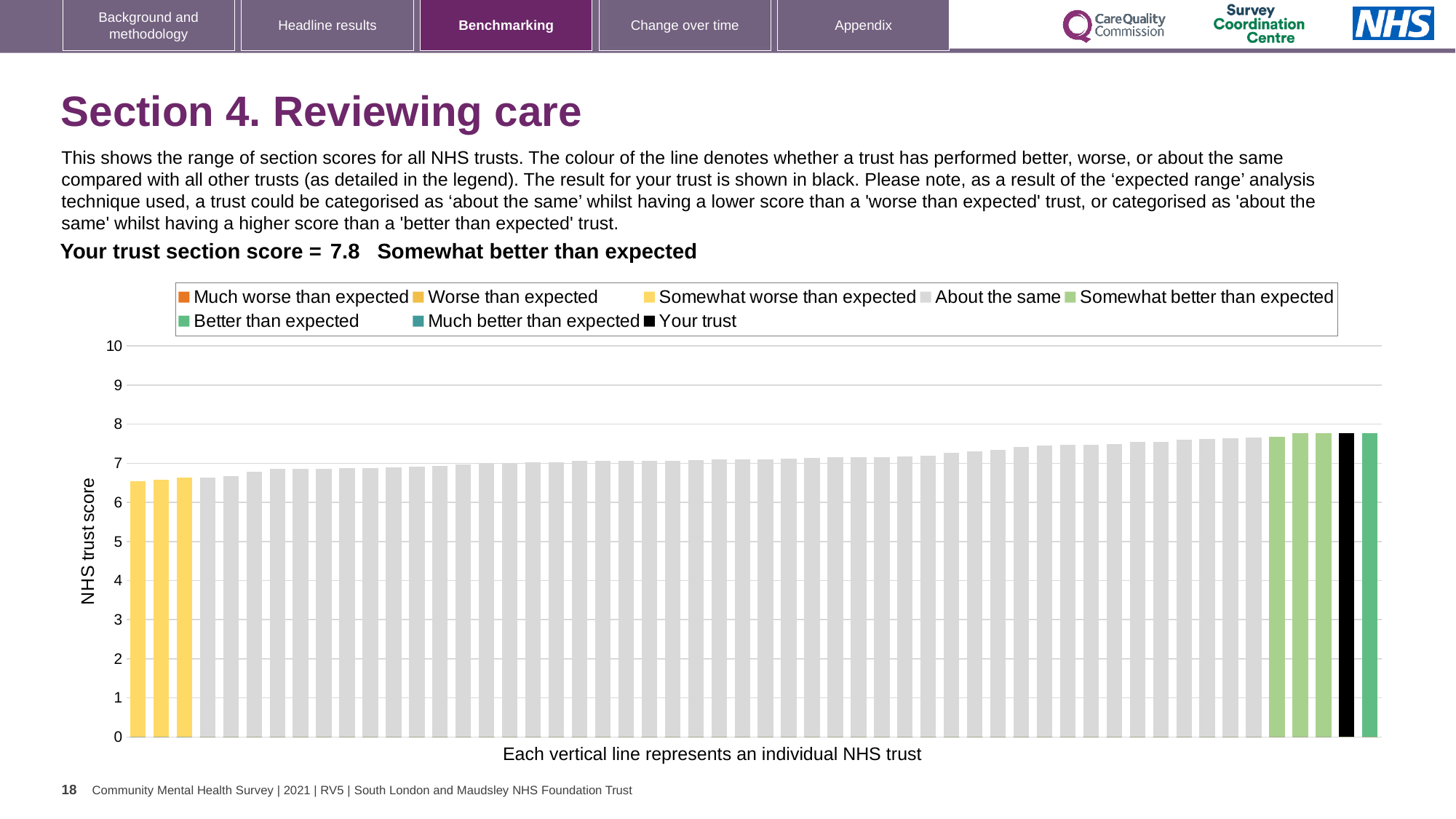
Is the value of the tallest bar in the chart greater or less than 8? less What kind of chart is shown on the slide? bar chart What is the label on the vertical axis of the chart? NHS trust score What is the section score for your trust shown on the slide? 7.8 How many bars are coloured as 'Much better than expected'? 0 Is the value of the black bar (your trust) greater or less than 7? greater Do the bar values rise or fall moving from left to right along the x axis? rise Is the value of the lowest bar in the chart greater or less than 6? greater Which performance category is your trust placed in for this section? Somewhat better than expected How many entries does the chart legend list? 8 How many bars are coloured as 'Somewhat better than expected' (light green)? 3